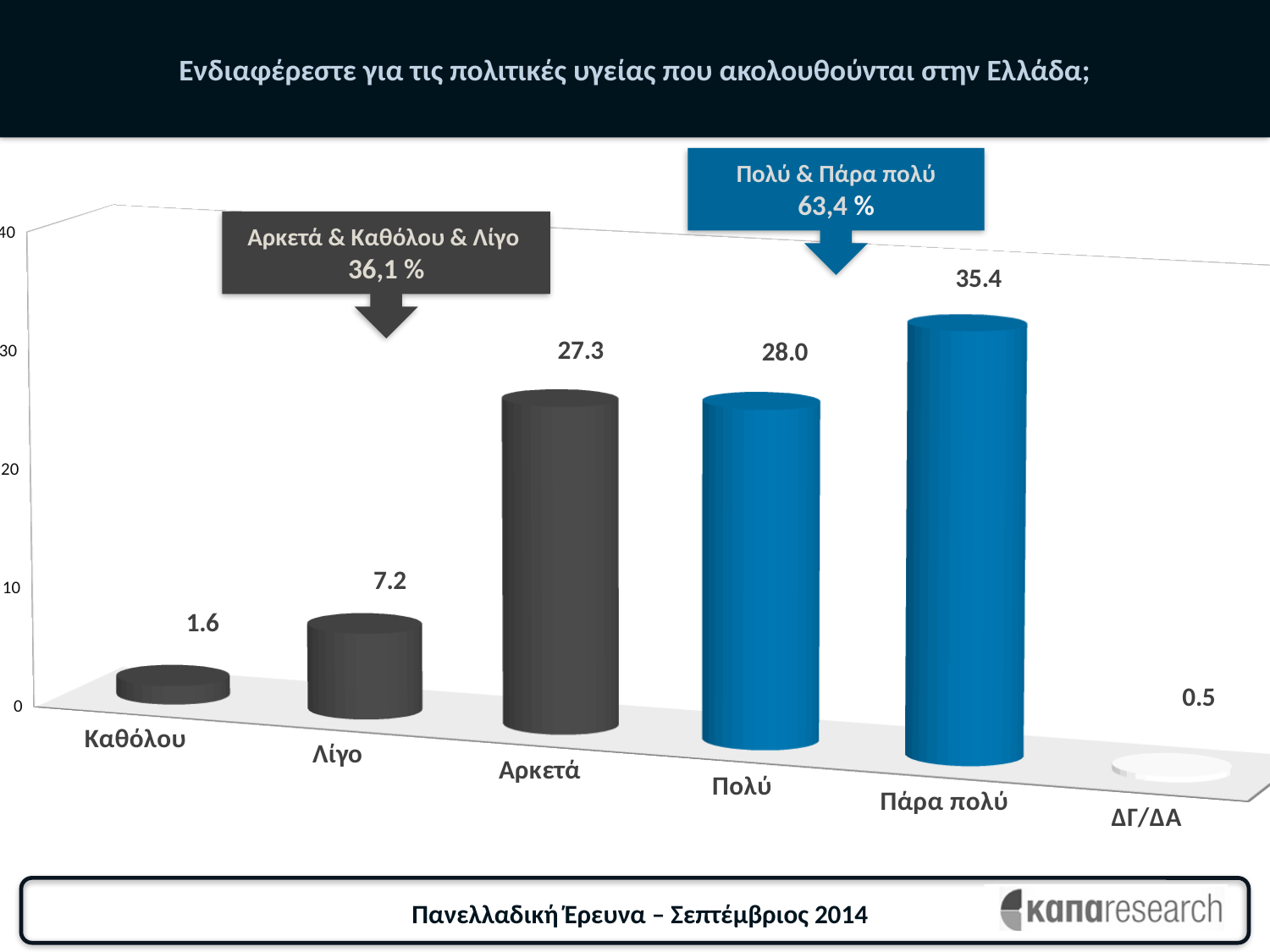
Which is larger, the value for Λίγο or the value for Αρκετά? Αρκετά Which category has the highest value? Πάρα πολύ What is the value for Πάρα πολύ? 35.4 How many categories are shown on the x axis? 6 Which category has the lowest value? ΔΓ/ΔΑ What is the value for Αρκετά? 27.3 What combined percentage does the callout give for Αρκετά & Καθόλου & Λίγο? 36,1 % What kind of chart is shown on the slide? bar chart What is the value for ΔΓ/ΔΑ? 0.5 What combined percentage does the callout give for Πολύ & Πάρα πολύ? 63,4 % What is the difference between the values for Πάρα πολύ and Πολύ? 7.4 What is the value for Καθόλου? 1.6